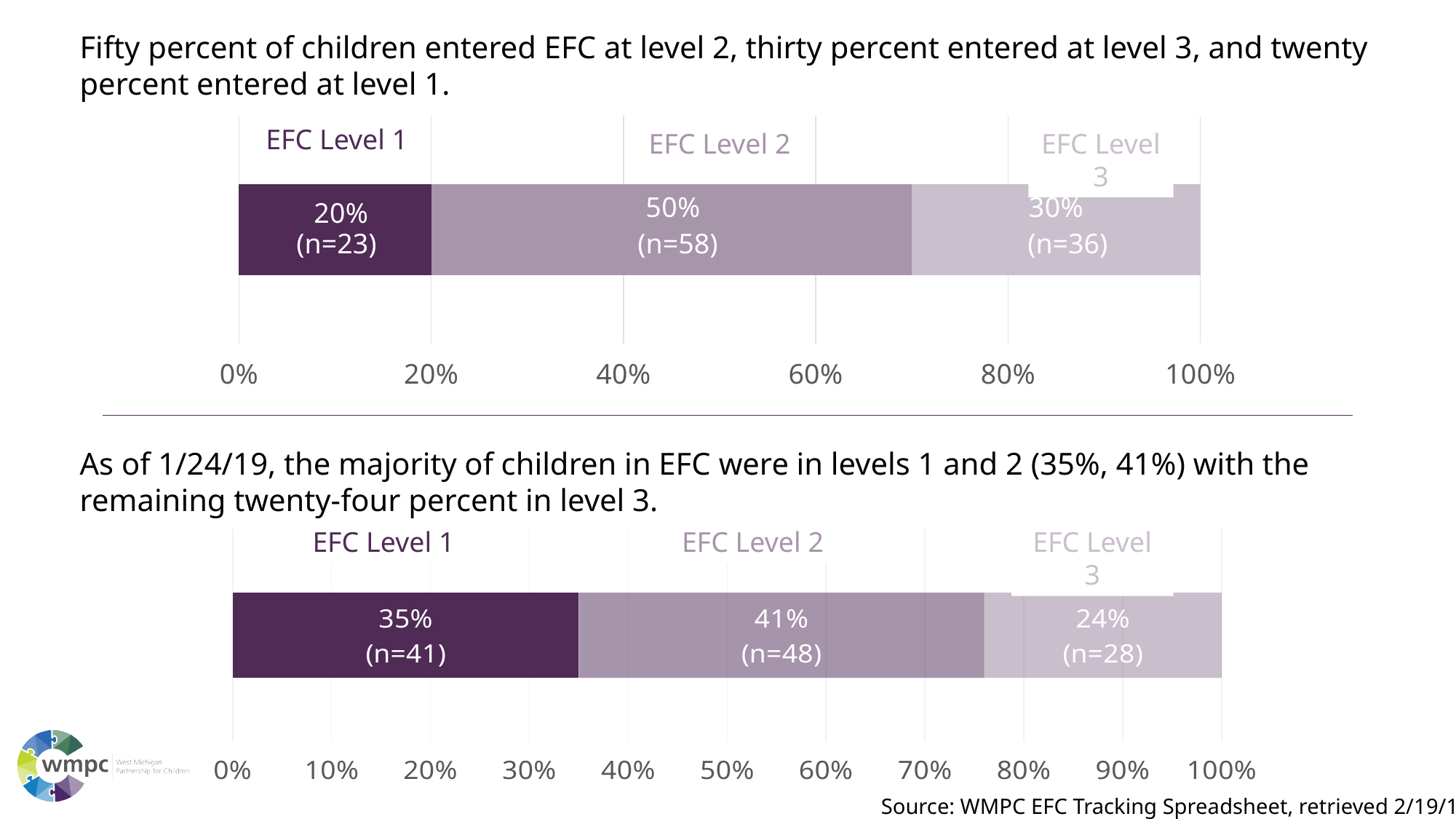
In the top chart, which EFC level has the smallest share of children? EFC Level 1 In the top chart, how many children (n) entered EFC at level 1? n=23 In the top chart, which EFC level has the largest share of children? EFC Level 2 In the bottom chart, what is the difference in percentage points between EFC Level 1 and EFC Level 3? 11% In the top chart, what is the difference in percentage points between EFC Level 2 and EFC Level 3? 20% How many EFC level segments are shown in the top chart? 3 What type of chart is the bottom chart? Stacked bar chart In the bottom chart, what percentage of children were in EFC Level 3 as of 1/24/19? 24% In the bottom chart, which is larger, the share for EFC Level 1 or EFC Level 3? EFC Level 1 In the bottom chart, how many children (n) were in EFC Level 2? n=48 In the top chart, what percentage of children entered EFC at level 2? 50% In the bottom chart, which EFC level has the largest share of children? EFC Level 2